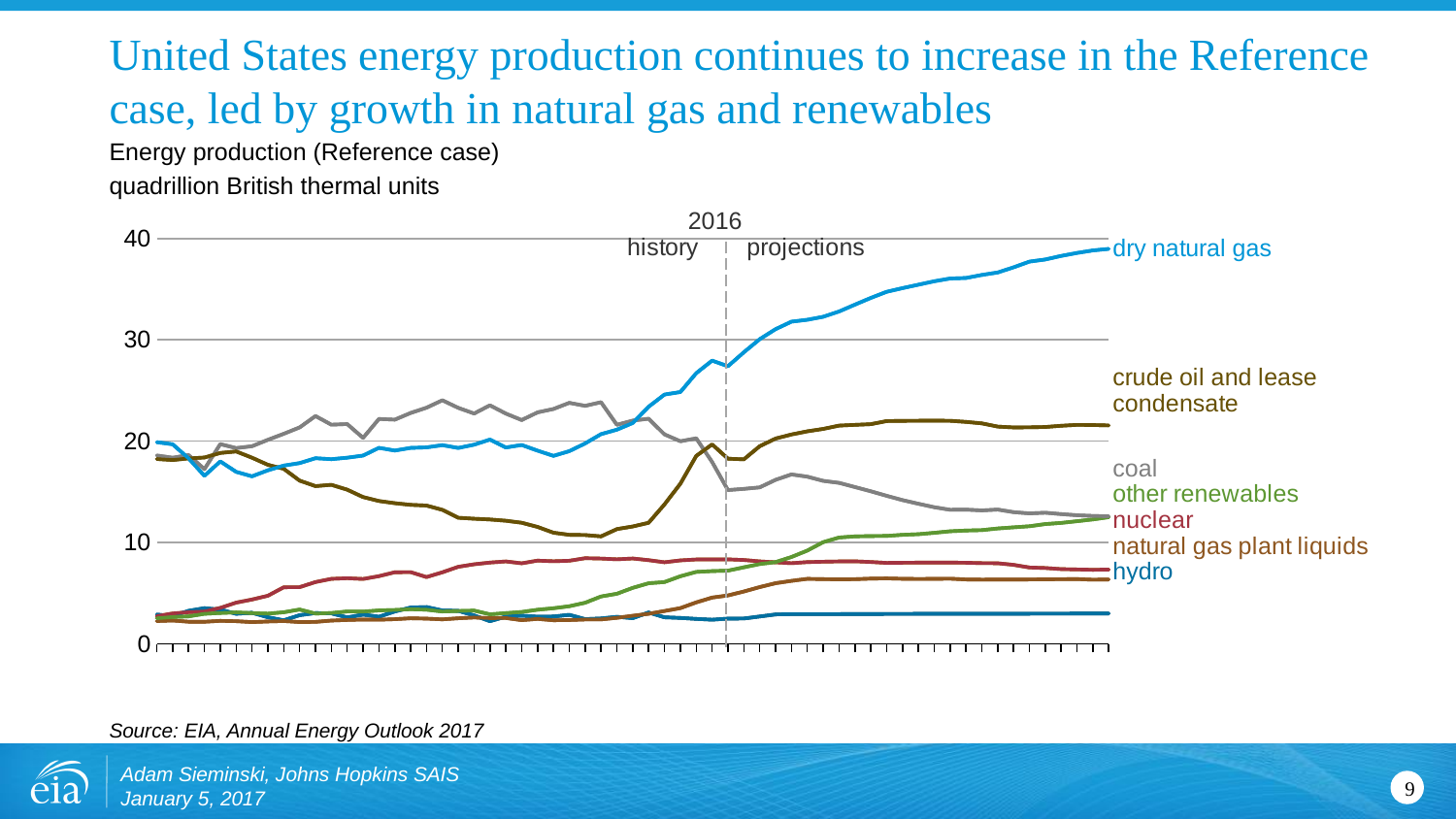
Which year marks the boundary between history and projections on the chart? 2016 At the end of the projection period, which is larger: crude oil and lease condensate or coal? crude oil and lease condensate Which energy source has the lowest production at the end of the projection period? hydro Is the value for crude oil and lease condensate at the end of the projection period greater or less than 20? greater Does dry natural gas production rise or fall over the projection period? rise Is the value for dry natural gas at the end of the projection period greater or less than 30? greater Which energy source has the highest production at the end of the projection period? dry natural gas Is the value for nuclear at the end of the projection period greater or less than 10? less What unit is used on the chart's y axis? quadrillion British thermal units What kind of chart is shown on the slide? line chart How many energy sources (series) are labelled on the chart? 7